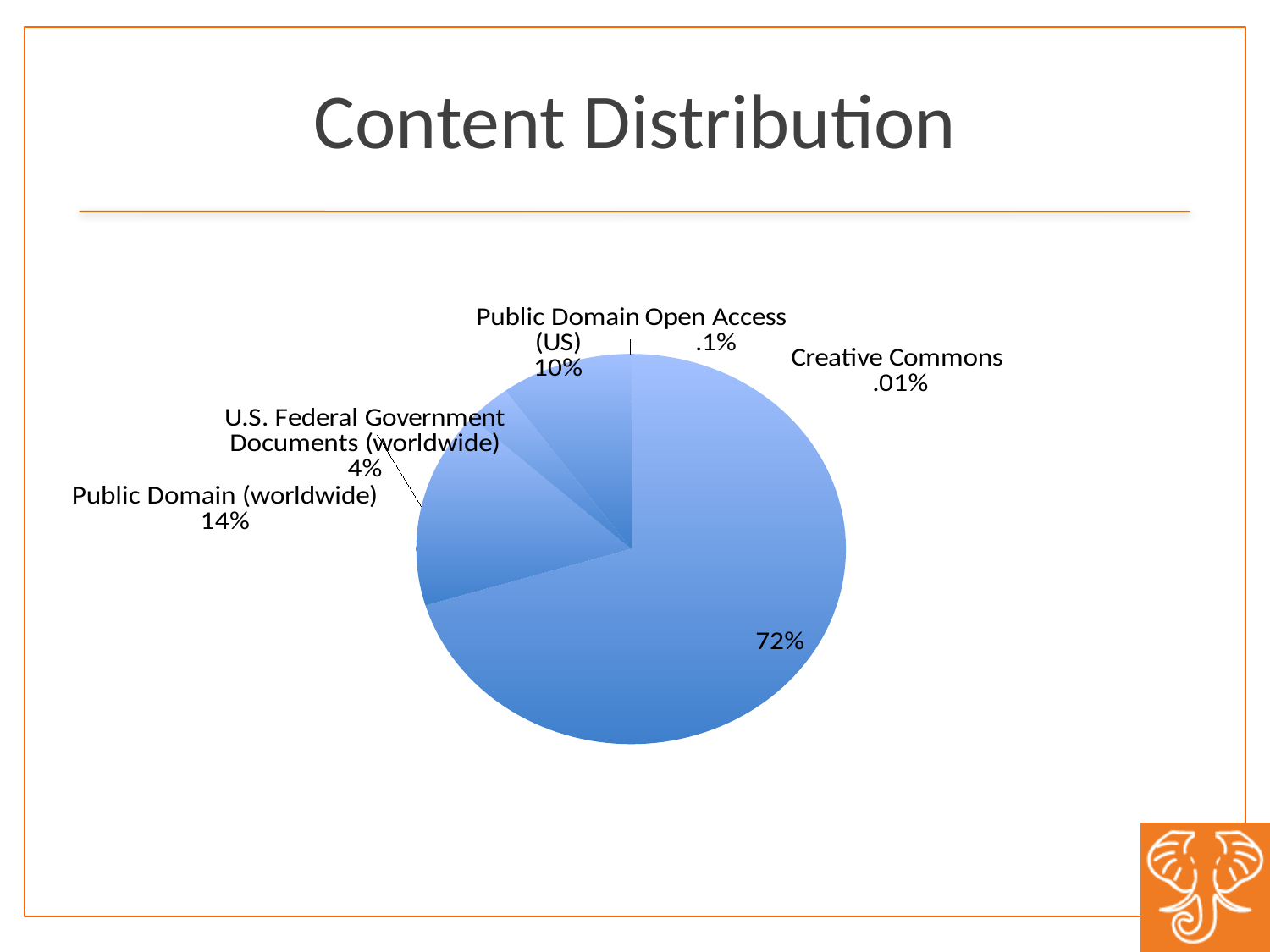
What percentage is shown for Open Access? .1% How many slices are labelled with a percentage on the pie chart? 6 What is the title of the slide containing the chart? Content Distribution Which named category has the smallest share of the pie? Creative Commons What is the largest percentage labelled on the pie chart? 72% Which has the larger share: Public Domain (US) or U.S. Federal Government Documents (worldwide)? Public Domain (US) What share does the Public Domain (US) slice have? 10% How many percentage points larger is Public Domain (worldwide) than U.S. Federal Government Documents (worldwide)? 10% What percentage is shown for U.S. Federal Government Documents (worldwide)? 4% What kind of chart is shown on the slide? Pie chart What percentage is shown for Creative Commons? .01% What percentage of the pie is labelled Public Domain (worldwide)? 14%